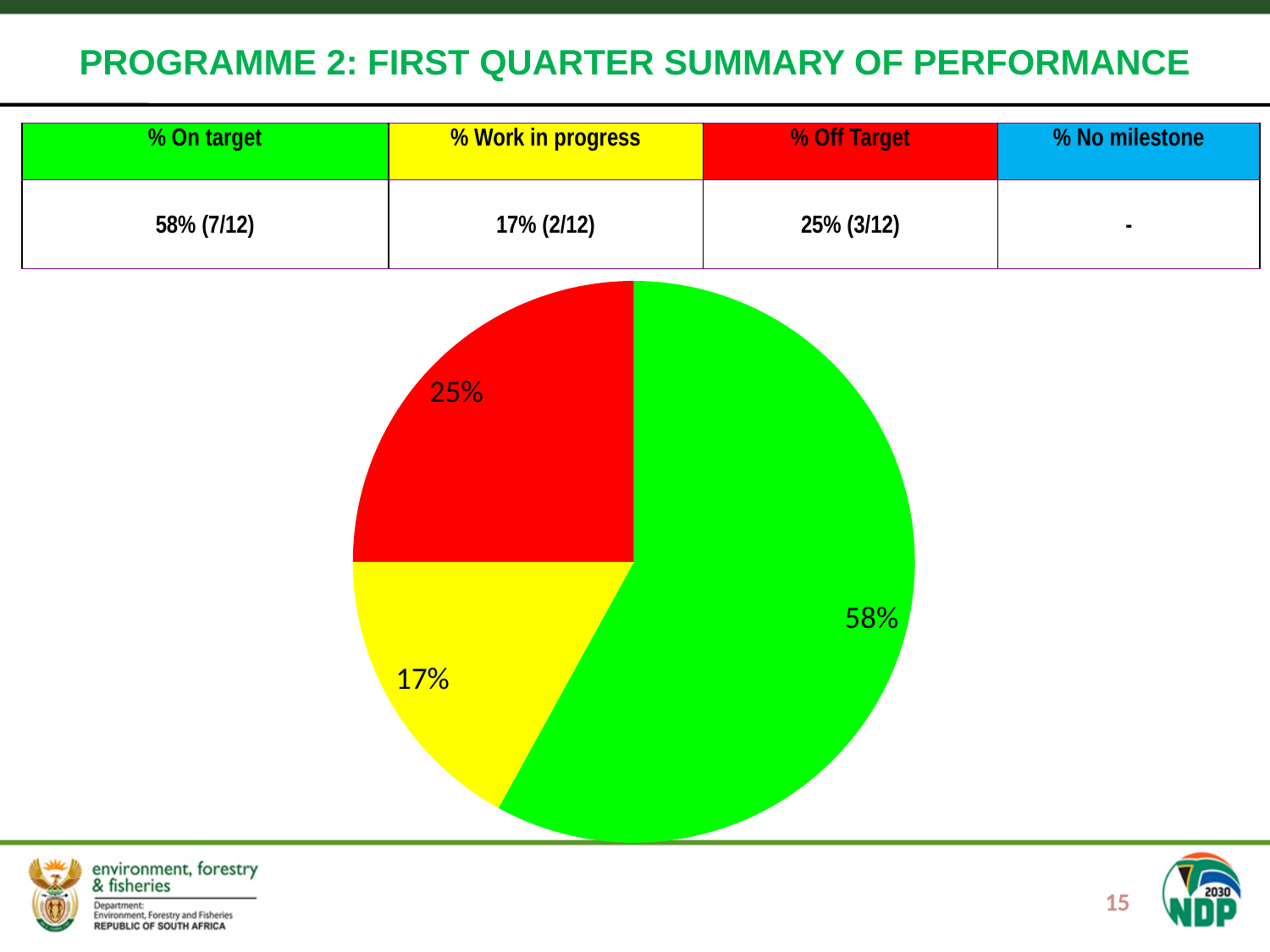
What share of the pie does the yellow slice represent? 17% According to the table above the pie chart, which performance category does the green colour represent? % On target What share of the pie does the red slice represent? 25% What share of the pie does the green slice represent? 58% What is the difference between the green slice and the red slice of the pie chart? 33% How many slices does the pie chart have? 3 Which slice of the pie chart is the largest? the green slice (58%) Which slice of the pie chart is the smallest? the yellow slice (17%) What is the difference between the red slice and the yellow slice of the pie chart? 8% Which is larger in the pie chart, the red slice or the yellow slice? the red slice What kind of chart is shown on the slide? pie chart Is the green slice of the pie chart greater or less than 50%? greater